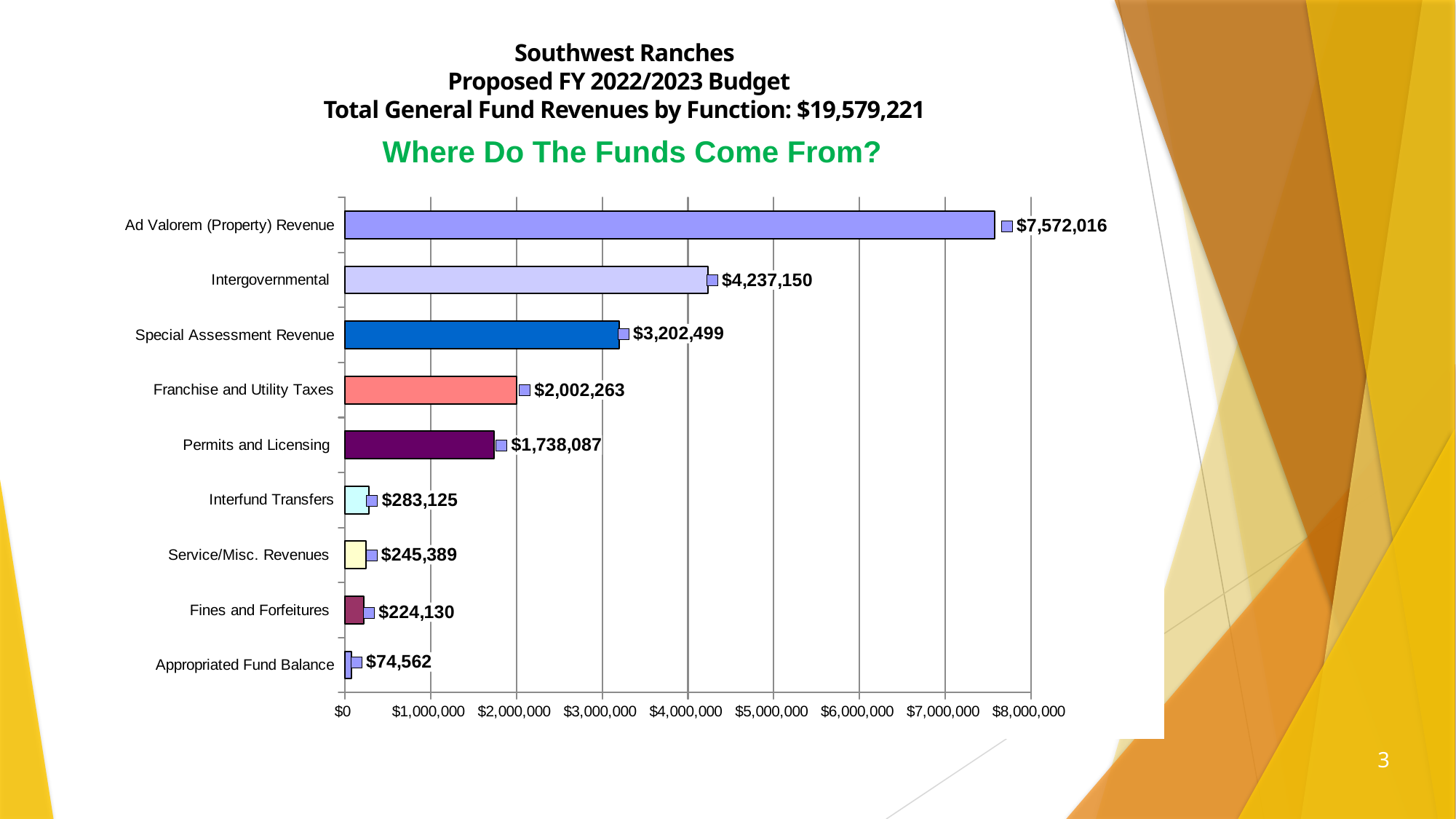
How many categories are shown in the chart? 9 What is the value for Ad Valorem (Property) Revenue? $7,572,016 Which category has the lowest value? Appropriated Fund Balance Which is larger, Interfund Transfers or Service/Misc. Revenues? Interfund Transfers What is the value for Special Assessment Revenue? $3,202,499 What is the difference between Franchise and Utility Taxes and Permits and Licensing? $264,176 What is the green heading above the chart? Where Do The Funds Come From? Is the value for Intergovernmental greater or less than $4,000,000? greater What is the value for Fines and Forfeitures? $224,130 What is the difference between Ad Valorem (Property) Revenue and Intergovernmental? $3,334,866 What kind of chart is shown on the slide? bar chart Which category has the highest value? Ad Valorem (Property) Revenue